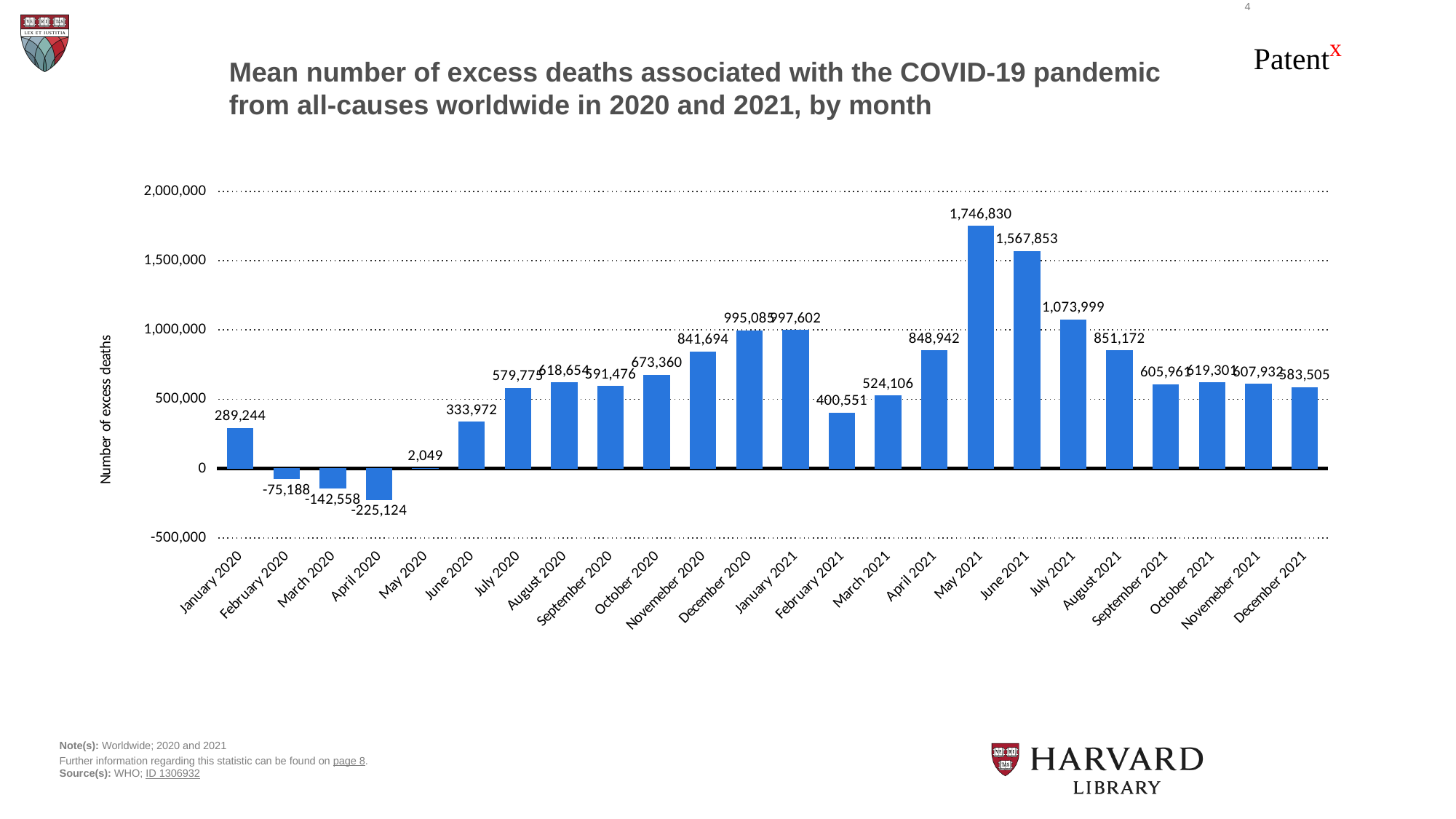
What is the value shown for April 2020? -225,124 How many months are plotted on the chart? 24 Do the values rise or fall from February 2021 to May 2021? Rise What kind of chart is shown on the slide? Bar chart What is the difference between the values for July 2021 and August 2021? 222,827 Which is larger, the value for January 2020 or the value for June 2020? June 2020 Is the value for February 2021 greater or less than 500,000? less What is the mean number of excess deaths for May 2021? 1,746,830 Which month has the lowest number of excess deaths? April 2020 What is the value shown for November 2020? 841,694 What is the difference between the values for May 2021 and June 2021? 178,977 Which month has the highest number of excess deaths? May 2021